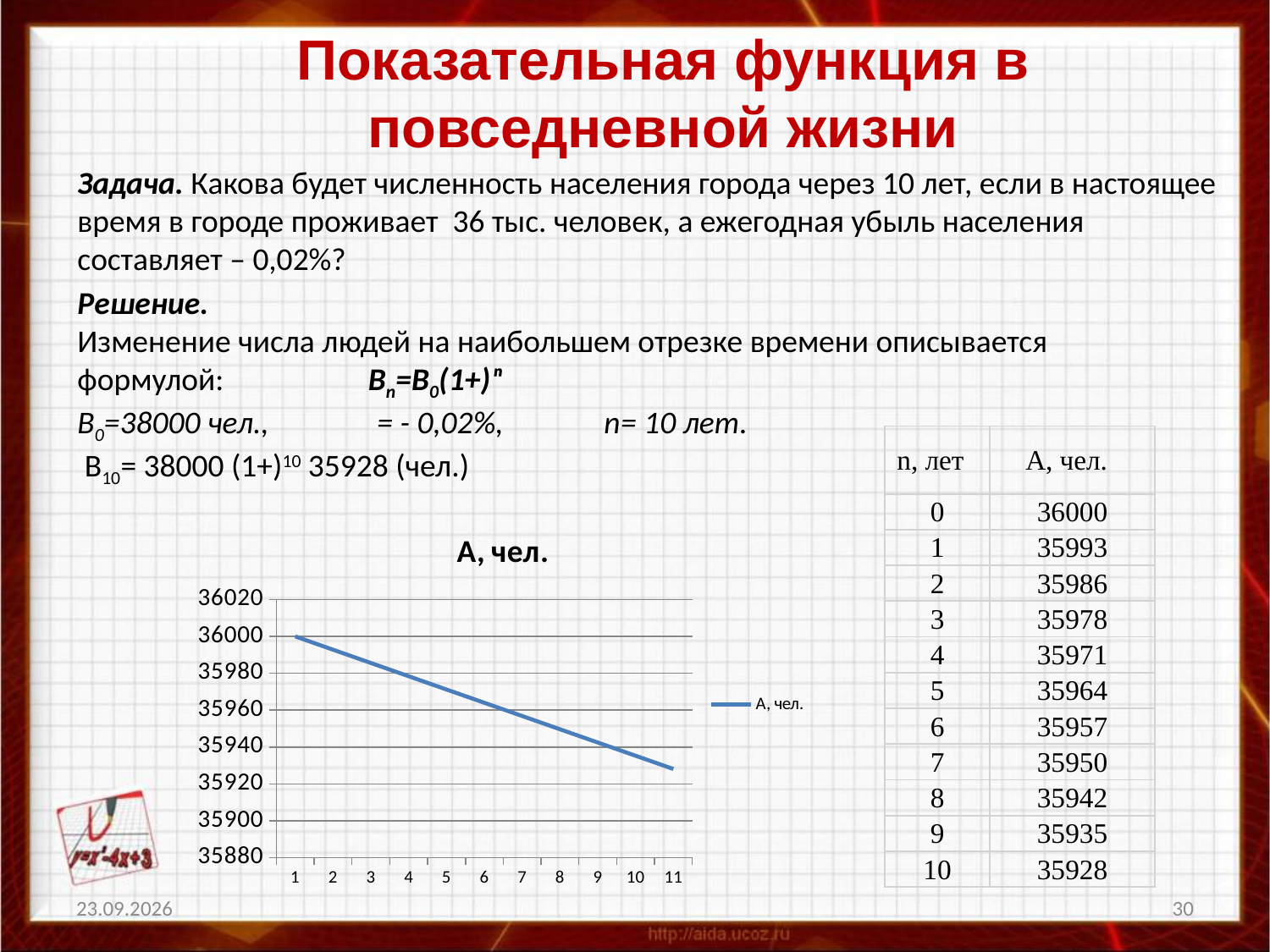
Do the values in the chart rise or fall as the x axis goes from 1 to 11? fall What kind of chart is shown on the slide? line chart How many points are plotted along the x axis of the chart? 11 What is the title of the chart? А, чел. Is the value at x = 11 greater or less than 35900? greater What is the value of the line at x = 1? 36000 Which is larger, the value at x = 1 or the value at x = 11? x = 1 Is the value at x = 6 greater or less than 35980? less How many series does the chart legend list? 1 At which x value is the line highest? 1 At which x value is the line lowest? 11 Is the value at x = 11 greater or less than 35940? less